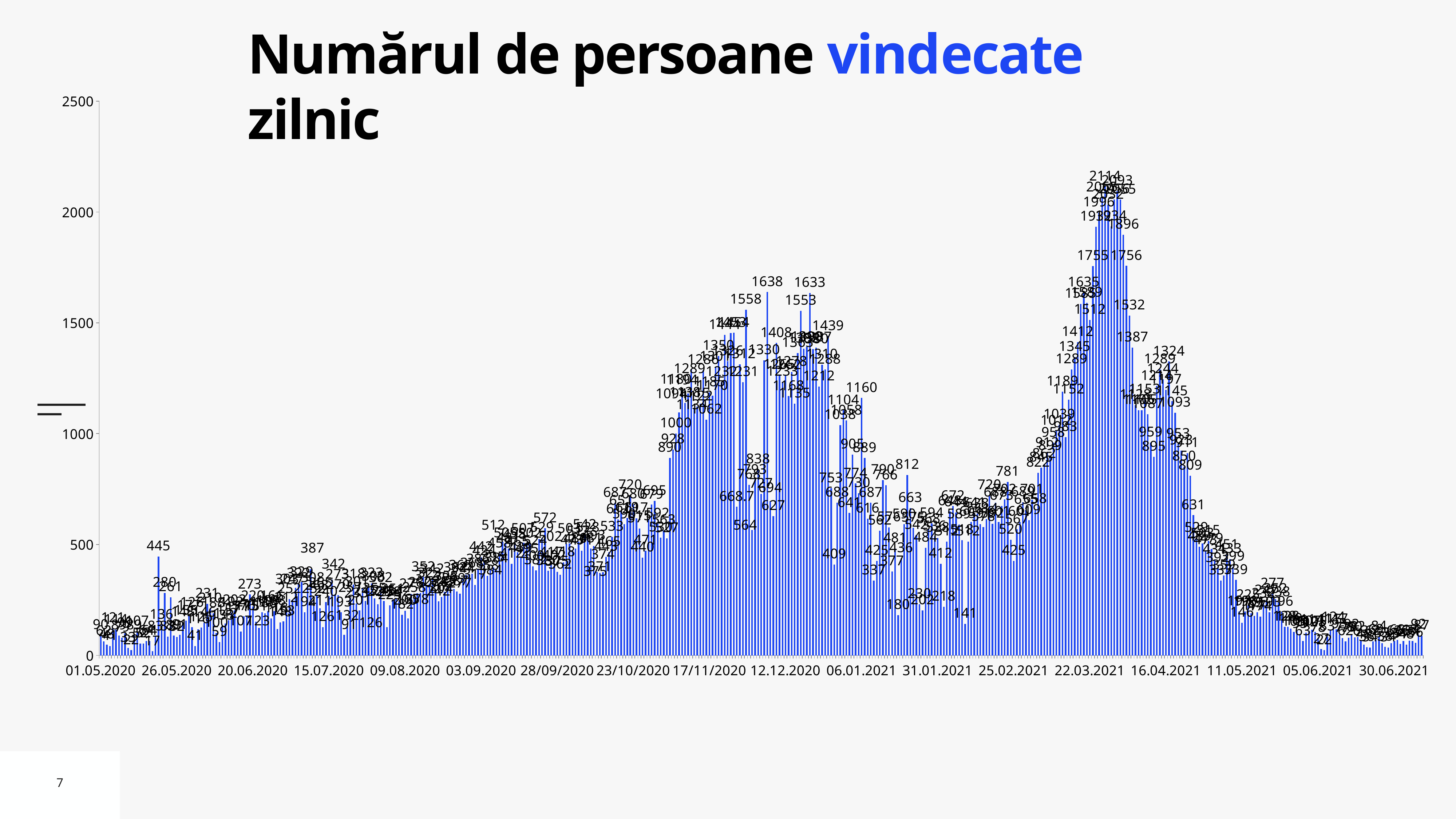
What is the highest data label shown on the chart? 2114 What kind of chart is shown on the slide? bar chart Is the highest bar near 22.03.2021 greater or less than 2000? greater What is the first date shown on the x axis? 01.05.2020 Do the values generally rise or fall between 11.05.2021 and 30.06.2021? fall What is the highest labeled value in the peak near 12.12.2020? 1638 What is the difference between the highest labeled value near 22.03.2021 (2114) and the highest labeled value near 12.12.2020 (1638)? 476 What is the last date shown on the x axis? 30.06.2021 Which peak is higher: the one near 12.12.2020 or the one near 22.03.2021? the one near 22.03.2021 What is the title of the chart? Numărul de persoane vindecate zilnic What is the highest value shown on the y axis? 2500 What is the highest labeled value near 26.05.2020? 445